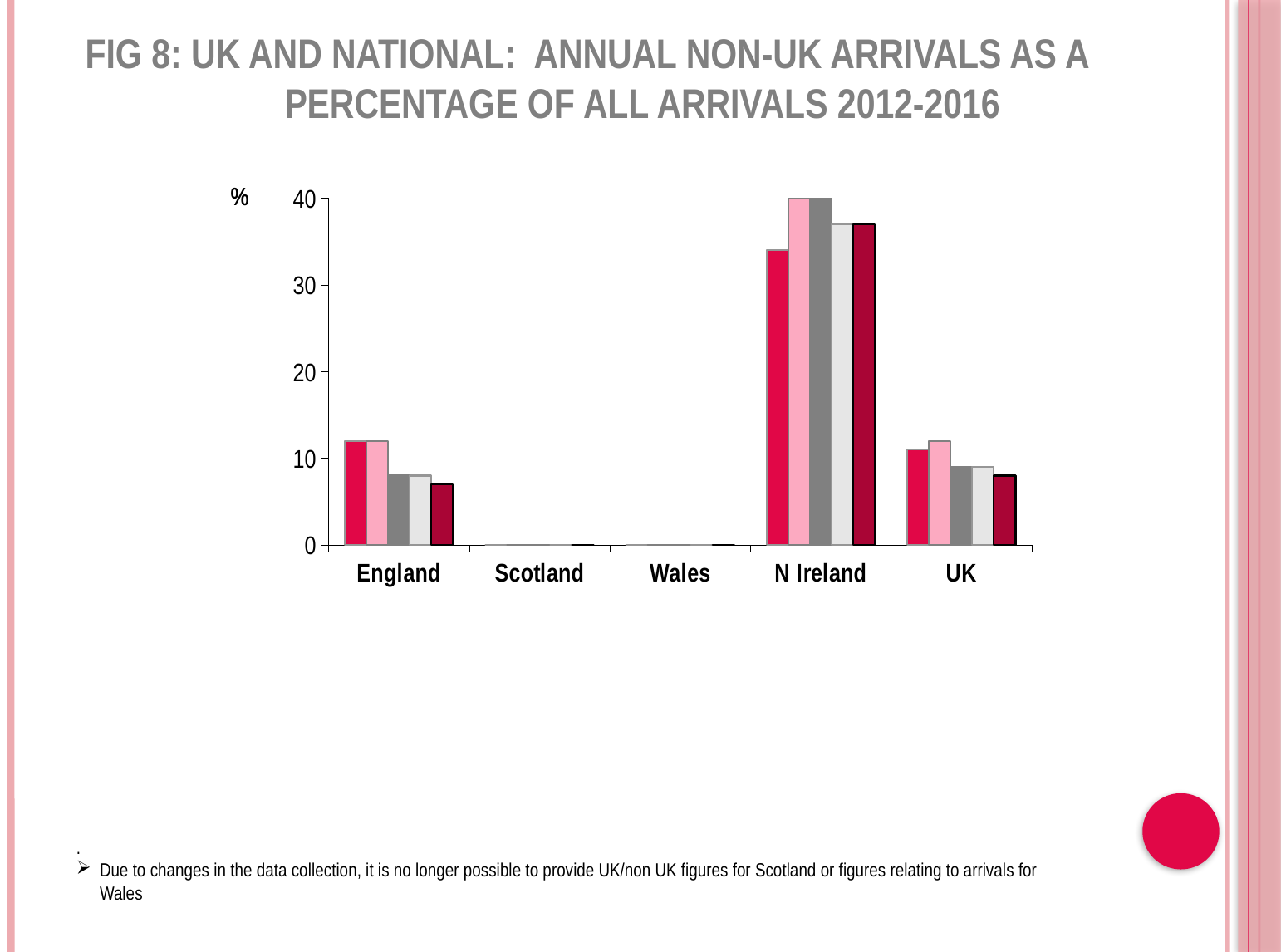
What kind of chart is shown on the slide? bar chart Which two categories show no visible bars in the chart? Scotland and Wales What unit label is shown next to the vertical axis of the chart? % How many categories are shown on the x axis of the chart? 5 Which category has the highest bars in the chart? N Ireland Is the value of the last (rightmost) bar for England greater or less than 10? less Is the value of the first (leftmost) bar for N Ireland greater or less than 30? greater Is the value of the first (leftmost) bar for England greater or less than 10? greater Which is larger: the first bar for N Ireland or the first bar for England? N Ireland Within the England group, do the bars generally rise or fall from left to right? fall How many bars are plotted for the England category? 5